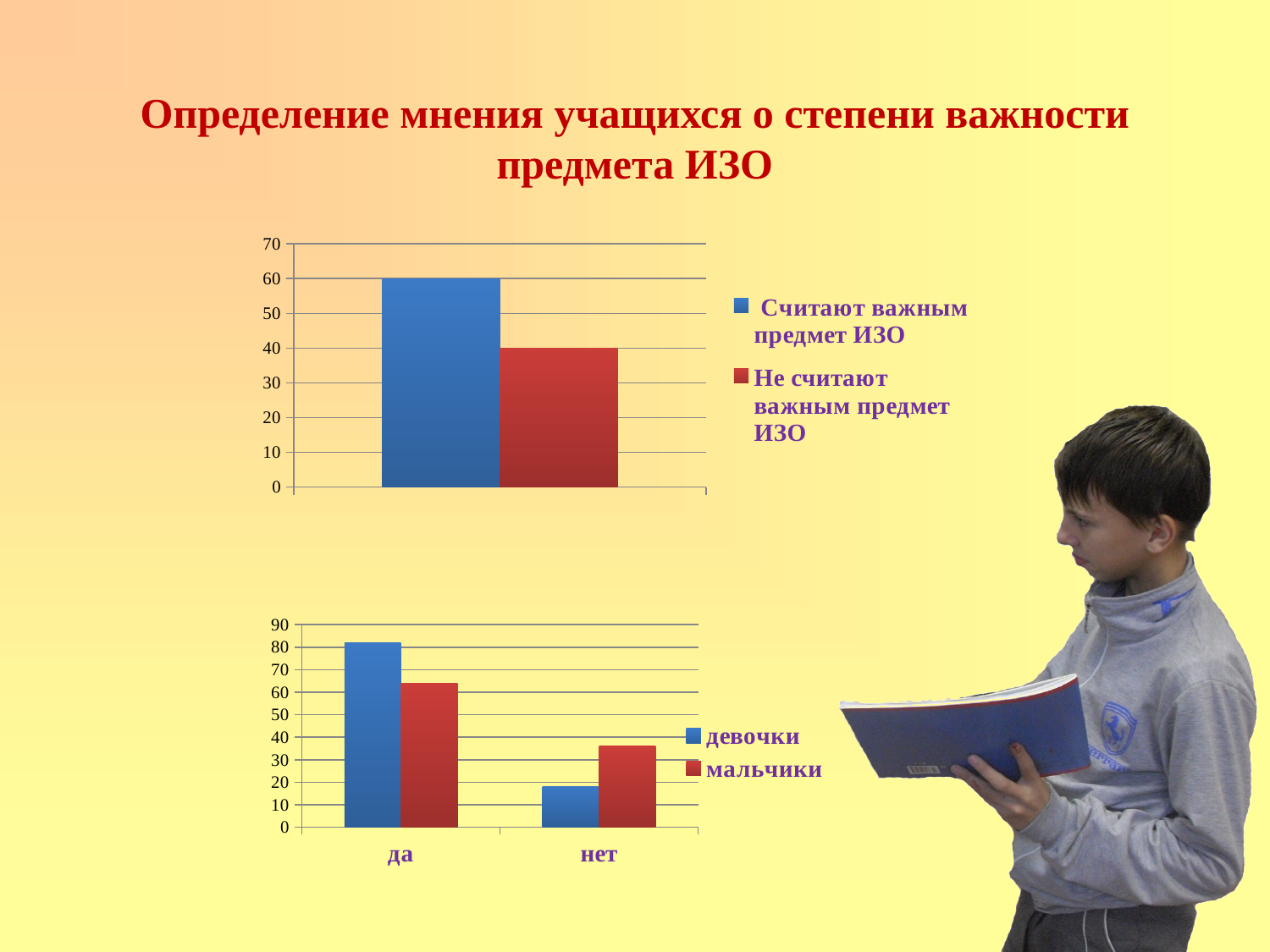
How many series does the legend of the top chart list? 2 What kind of chart is the bottom chart? bar chart How many categories are shown on the x axis of the bottom chart? 2 In the top chart, what is the difference between 'Считают важным предмет ИЗО' and 'Не считают важным предмет ИЗО'? 20 In the top chart, what is the value for 'Считают важным предмет ИЗО'? 60 In the bottom chart, which colour represents 'мальчики'? red In the bottom chart, is the value for 'мальчики' in the 'нет' category greater or less than 30? greater In the top chart, what is the value for 'Не считают важным предмет ИЗО'? 40 In the bottom chart, which series has the larger value in the 'да' category: 'девочки' or 'мальчики'? девочки In the top chart, which series has the larger value: 'Считают важным предмет ИЗО' or 'Не считают важным предмет ИЗО'? Считают важным предмет ИЗО